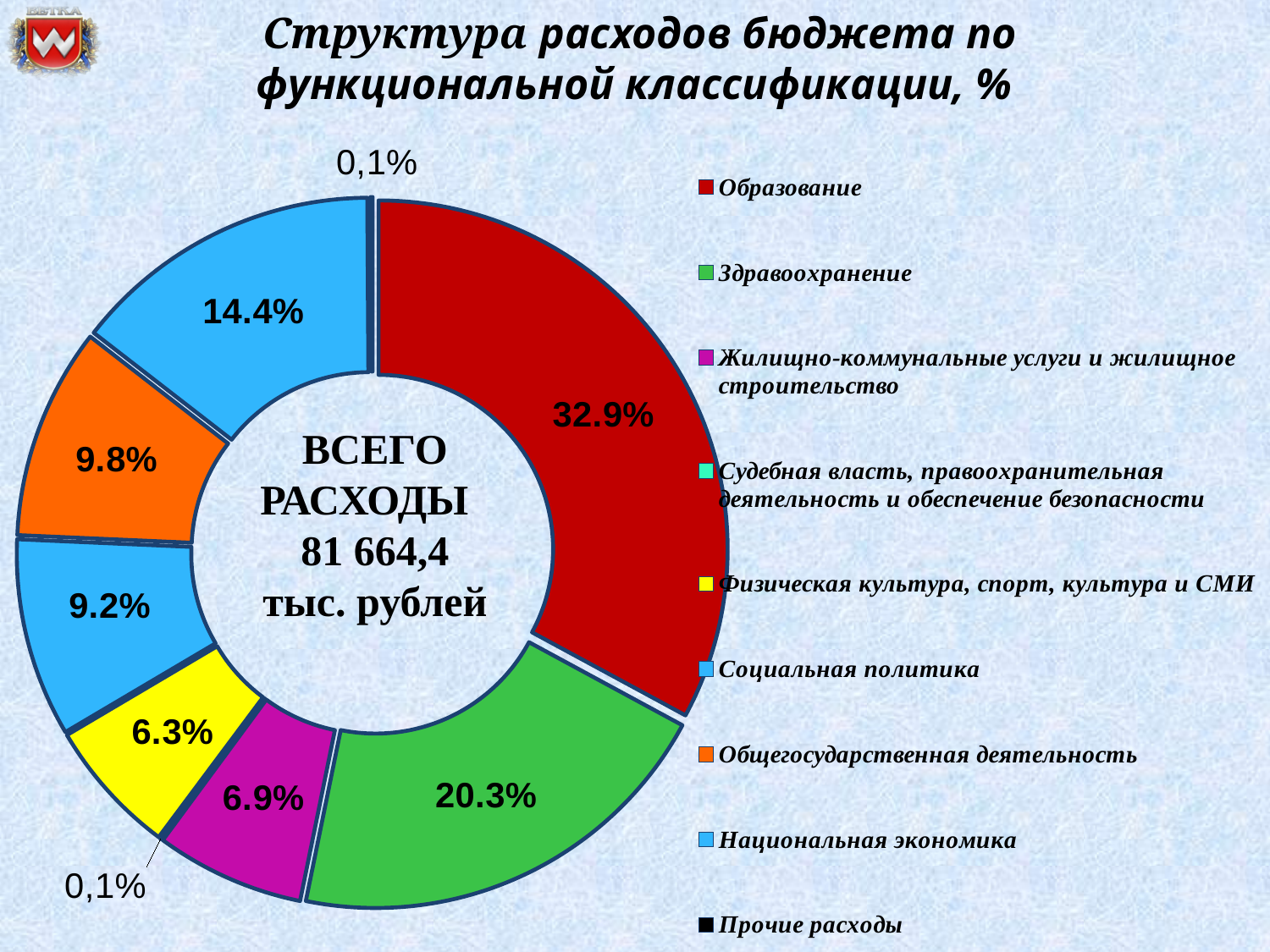
What share of budget expenditures goes to Физическая культура, спорт, культура и СМИ? 6.3% What share of budget expenditures goes to Общегосударственная деятельность? 9.8% What share of budget expenditures goes to Прочие расходы? 0,1% Which category has the largest share of budget expenditures? Образование What total expenditure amount is shown in the centre of the chart? 81 664,4 тыс. рублей What share of budget expenditures goes to Образование? 32.9% What share of budget expenditures goes to Жилищно-коммунальные услуги и жилищное строительство? 6.9% What kind of chart is shown on the slide? Doughnut (pie) chart Which has the larger share: Общегосударственная деятельность or Физическая культура, спорт, культура и СМИ? Общегосударственная деятельность How many categories does the legend list? 9 What share of budget expenditures goes to Здравоохранение? 20.3% By how many percentage points does the share of Образование exceed the share of Здравоохранение? 12.6